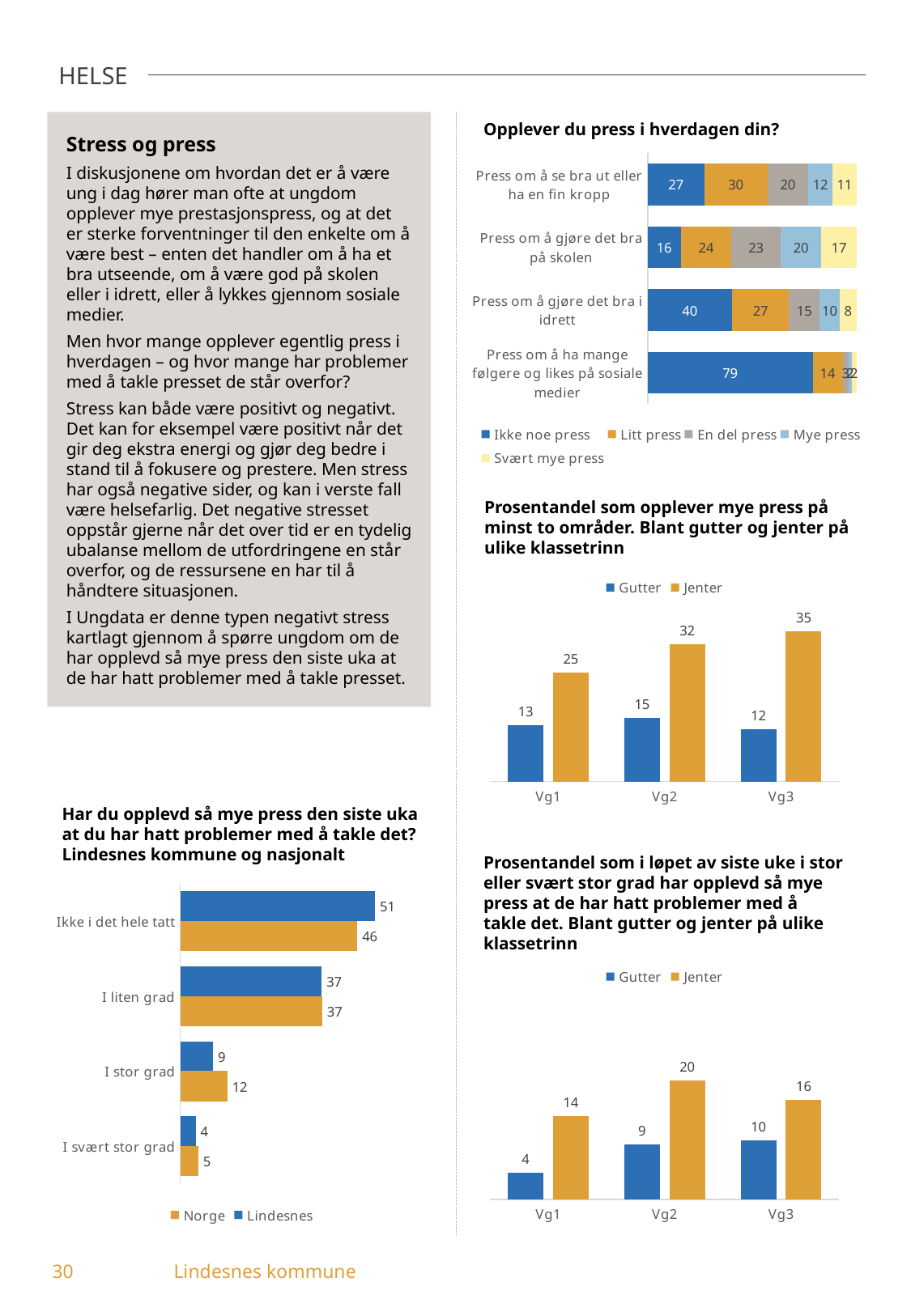
In the chart 'Opplever du press i hverdagen din?', which category has the highest value for 'Ikke noe press'? Press om å ha mange følgere og likes på sosiale medier In the chart 'Prosentandel som opplever mye press på minst to områder', what is the difference between Jenter and Gutter at Vg3? 23 In the chart 'Prosentandel som opplever mye press på minst to områder', do the Jenter values rise or fall from Vg1 to Vg3? rise In the chart 'Opplever du press i hverdagen din?', what is the value for 'Litt press' for 'Press om å se bra ut eller ha en fin kropp'? 30 How many categories are shown in the chart 'Har du opplevd så mye press den siste uka at du har hatt problemer med å takle det?'? 4 In the chart 'Prosentandel som opplever mye press på minst to områder', what is the value for Jenter at Vg2? 32 In the chart 'Har du opplevd så mye press den siste uka at du har hatt problemer med å takle det?', what is the value for Lindesnes for 'Ikke i det hele tatt'? 51 In the chart 'Har du opplevd så mye press den siste uka at du har hatt problemer med å takle det?', which is larger for 'I stor grad': Norge or Lindesnes? Norge How many series does the legend list in the chart 'Opplever du press i hverdagen din?'? 5 In the chart 'Opplever du press i hverdagen din?', what is the value for 'Ikke noe press' for 'Press om å ha mange følgere og likes på sosiale medier'? 79 In the bottom-right chart ('Prosentandel som i løpet av siste uke i stor eller svært stor grad har opplevd så mye press...'), what is the value for Gutter at Vg1? 4 In the bottom-right chart ('Prosentandel som i løpet av siste uke i stor eller svært stor grad har opplevd så mye press...'), which class level has the highest value for Jenter? Vg2